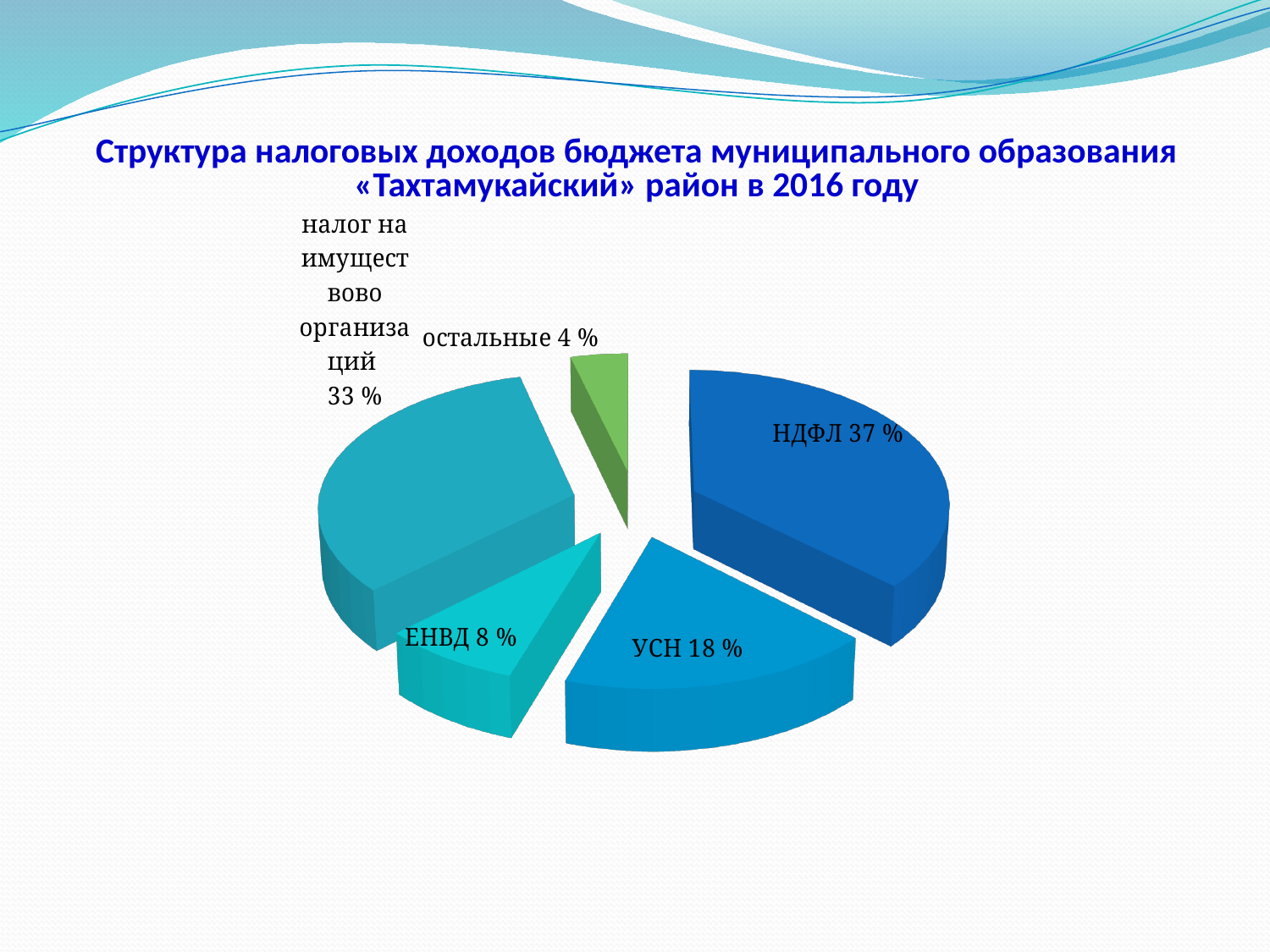
What share of tax revenues does НДФЛ account for? 37 % What share does УСН account for? 18 % Which is larger, the share of ЕНВД or the share of остальные? ЕНВД What share does налог на имущество организаций account for? 33 % What year does the chart title refer to? 2016 Which slice of the pie is the largest? НДФЛ Which slice of the pie is the smallest? остальные What share does ЕНВД account for? 8 % What is the difference in percentage points between НДФЛ and УСН? 19 What share does остальные account for? 4 % What kind of chart is shown on the slide? pie chart How many slices does the pie chart have? 5